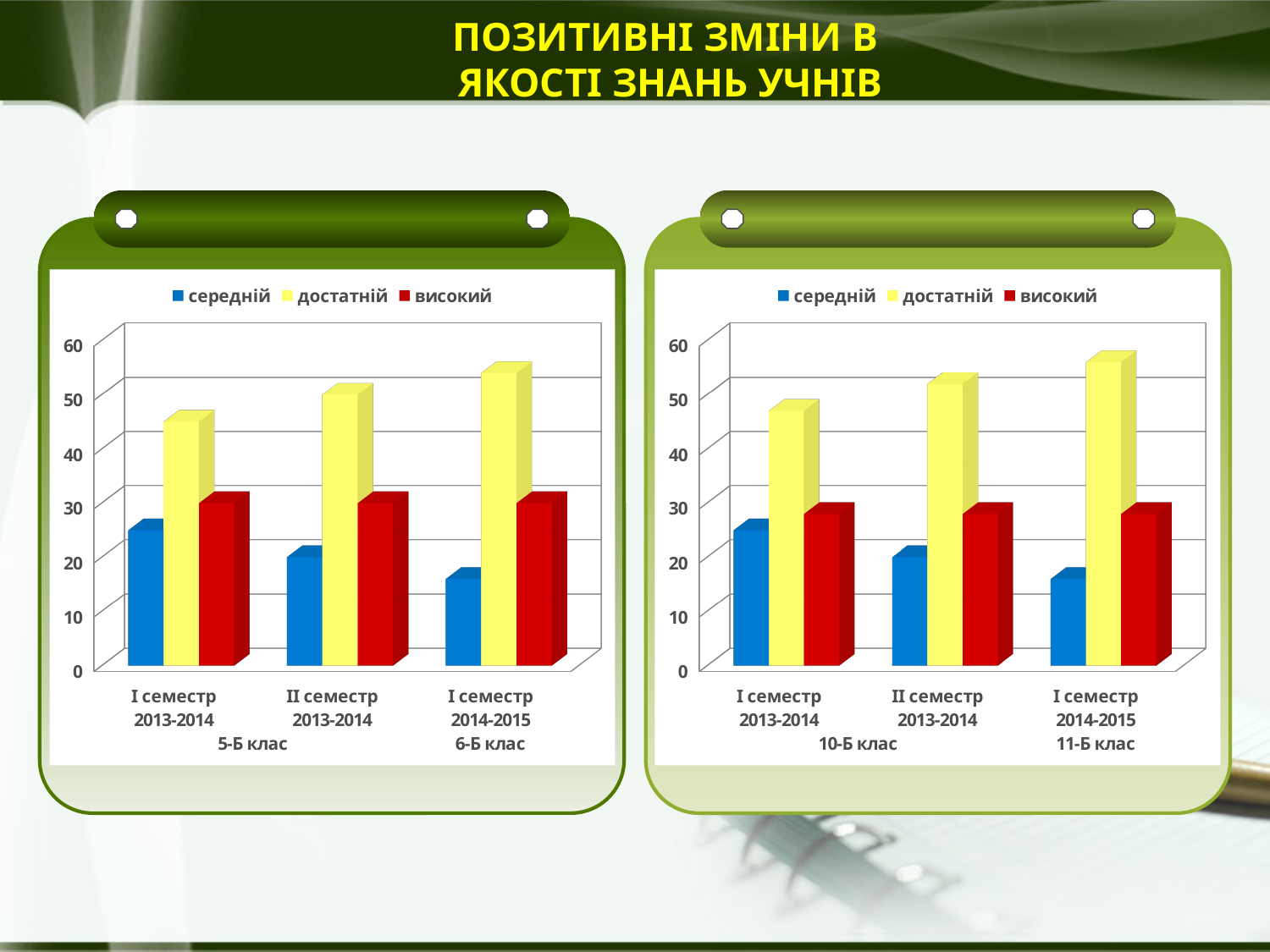
In the left chart, is the value of середній for I семестр 2013-2014 greater or less than 20? greater In the left chart, does the середній series rise or fall across the semesters from left to right? fall In the left chart, is the value of достатній for I семестр 2014-2015 greater or less than 50? greater In the right chart, does the достатній series rise or fall across the semesters from left to right? rise In the right chart, which series has the lowest bar for I семестр 2014-2015? середній What kind of chart is the left chart on the slide? bar chart In the right chart, which is larger for II семестр 2013-2014: достатній or високий? достатній In the left chart, which series has the tallest bar for I семестр 2014-2015? достатній In the right chart, is the value of достатній for I семестр 2013-2014 greater or less than 40? greater How many categories are shown on the x axis of the left chart? 3 How many series does the legend of the right chart list? 3